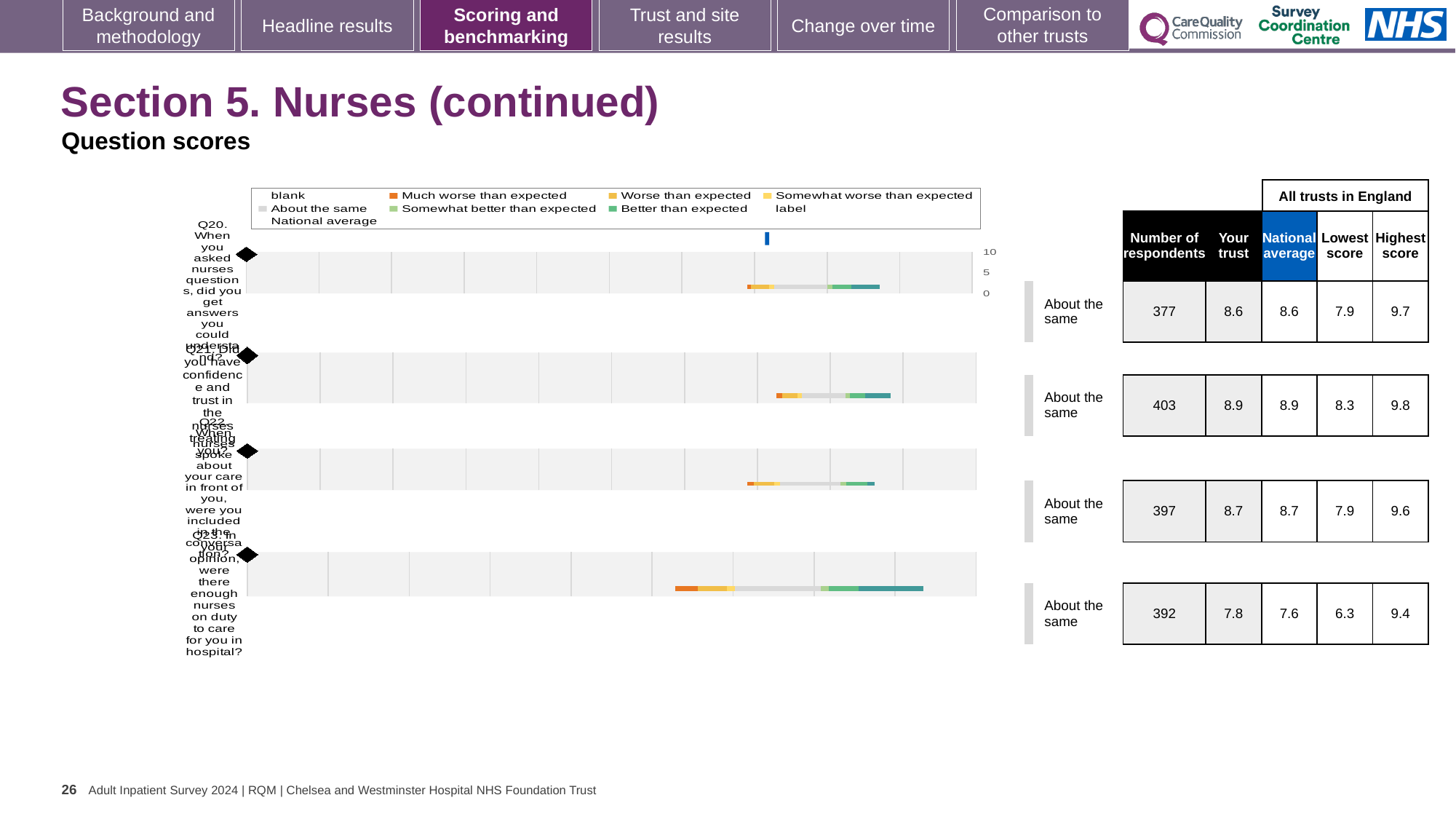
How many questions are plotted on the chart? 4 How many respondents answered Q25 about whether there were enough nurses on duty? 392 What benchmark category is shown for Q22 (nurses speaking about your care in front of you)? About the same What is the difference between the highest score and the lowest score for Q25? 3.1 What is the national average score for Q25? 7.6 For Q25, is the 'Your trust' score or the national average score larger? Your trust Which question has the highest 'Your trust' score? Q21 What kind of chart is used to show the question scores? Bar chart What is the maximum value shown on the chart's score axis? 10 What is the 'Your trust' score for Q21 (confidence and trust in the nurses)? 8.9 Which question has the lowest 'Your trust' score? Q25 What is the highest score among all trusts in England for Q21? 9.8